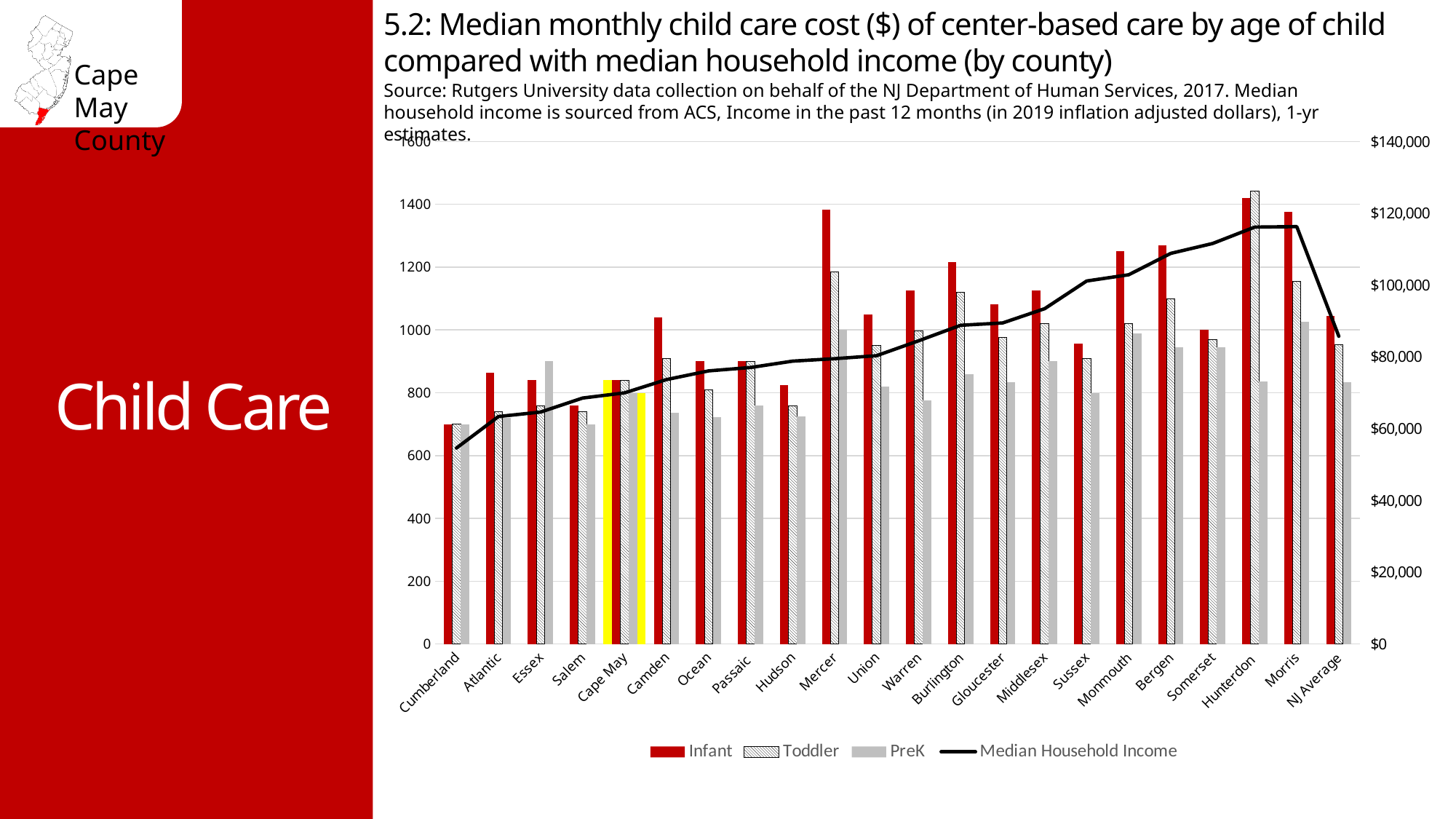
Which category has the highest Toddler bar? Hunterdon Is the Infant value for Cumberland greater or less than 800? less Which is larger, the Infant value for Mercer or the Infant value for Camden? Mercer How many counties/categories are shown on the x axis? 22 Which county has the lowest Infant bar? Cumberland Does the Median Household Income line generally rise or fall from Cumberland to Morris? rise How many series does the legend list? 4 What kind of chart is this? Bar chart with a line Which county's bars are highlighted in yellow? Cape May Is the Toddler value for Hunterdon greater or less than 1400? greater Is the Infant value for Mercer greater or less than 1200? greater